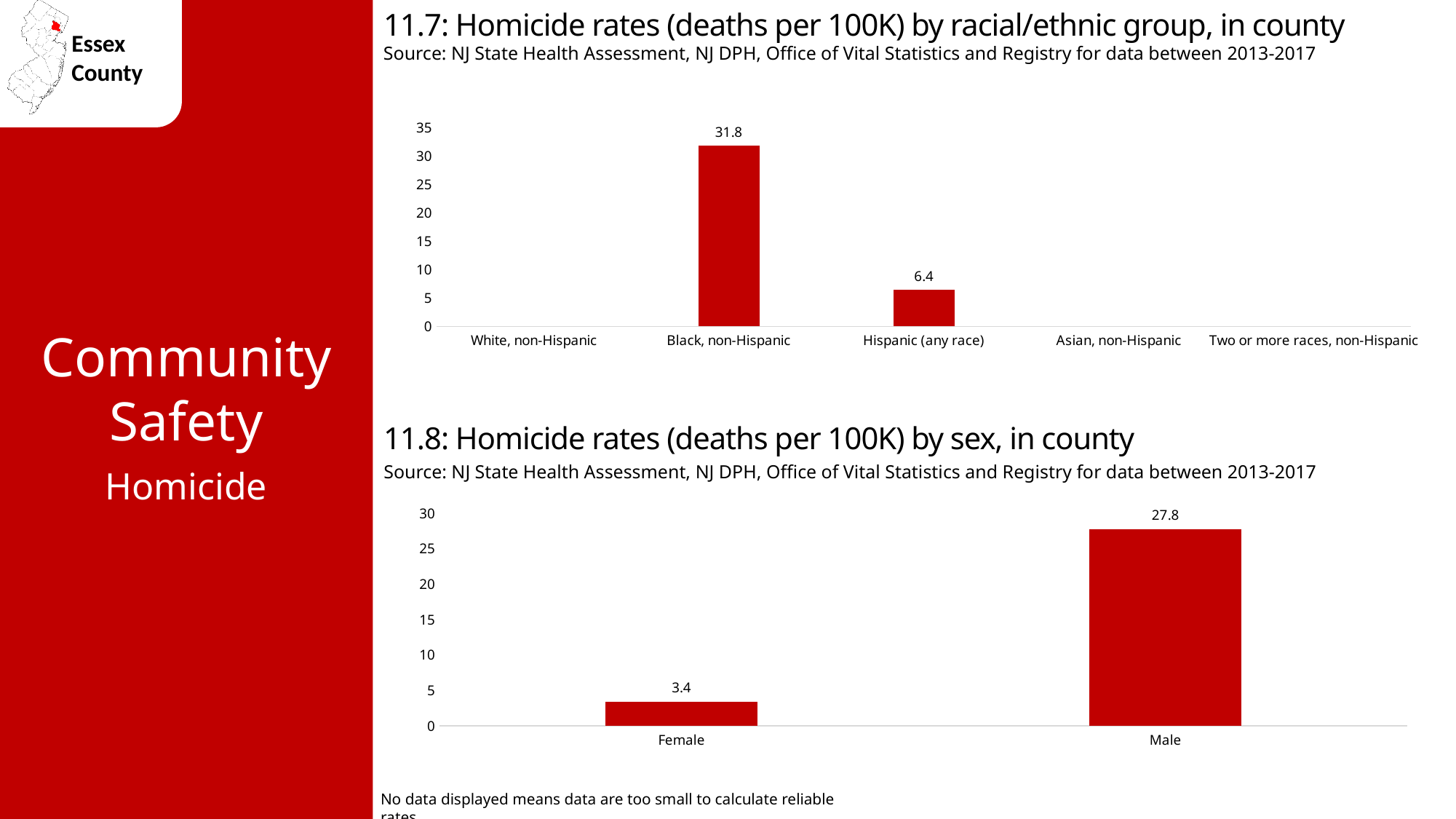
In the chart '11.8: Homicide rates (deaths per 100K) by sex, in county', what is the homicide rate for Female? 3.4 In the chart '11.7: Homicide rates (deaths per 100K) by racial/ethnic group, in county', which racial/ethnic group has the highest homicide rate? Black, non-Hispanic In the chart '11.7: Homicide rates (deaths per 100K) by racial/ethnic group, in county', what is the homicide rate for Hispanic (any race)? 6.4 In the chart '11.7: Homicide rates (deaths per 100K) by racial/ethnic group, in county', is the value for Black, non-Hispanic greater or less than 30? greater In the chart '11.8: Homicide rates (deaths per 100K) by sex, in county', what is the difference between the Male and Female homicide rates? 24.4 What kind of chart is '11.8: Homicide rates (deaths per 100K) by sex, in county'? bar chart In the chart '11.8: Homicide rates (deaths per 100K) by sex, in county', which sex has the lower homicide rate? Female In the chart '11.8: Homicide rates (deaths per 100K) by sex, in county', what is the homicide rate for Male? 27.8 In the chart '11.7: Homicide rates (deaths per 100K) by racial/ethnic group, in county', what is the difference between the rates for Black, non-Hispanic and Hispanic (any race)? 25.4 In the chart '11.8: Homicide rates (deaths per 100K) by sex, in county', is the value for Female greater or less than 5? less In the chart '11.7: Homicide rates (deaths per 100K) by racial/ethnic group, in county', how many racial/ethnic group categories are listed on the x axis? 5 In the chart '11.7: Homicide rates (deaths per 100K) by racial/ethnic group, in county', what is the homicide rate for Black, non-Hispanic? 31.8